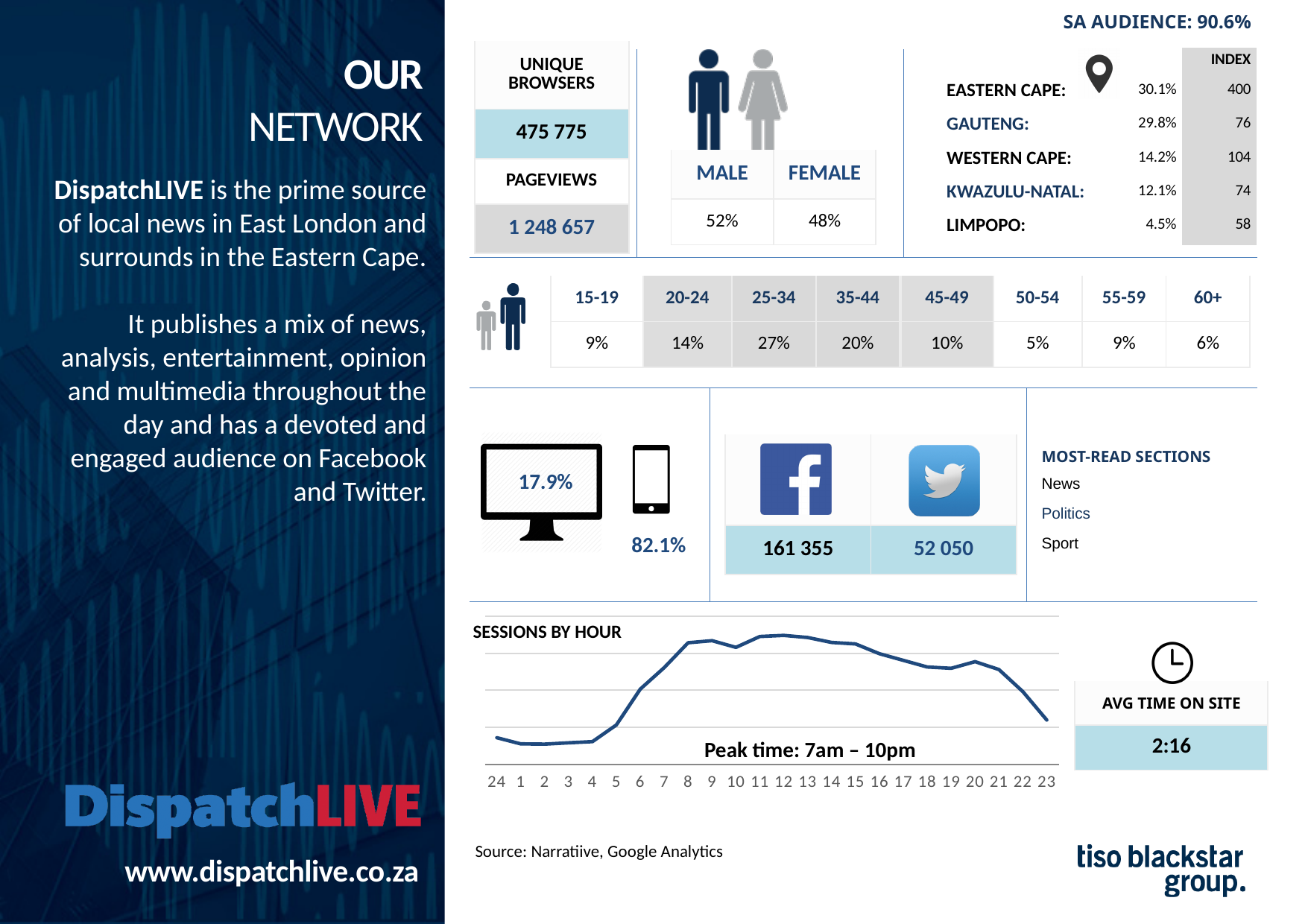
How many hour points are plotted along the x axis of the SESSIONS BY HOUR chart? 24 What kind of chart is the SESSIONS BY HOUR chart? line chart What is the first label on the x axis of the SESSIONS BY HOUR chart? 24 In the SESSIONS BY HOUR chart, which hour has more sessions, hour 23 or hour 20? 20 How many lines are plotted in the SESSIONS BY HOUR chart? 1 According to the annotation on the SESSIONS BY HOUR chart, what is the peak time? 7am – 10pm In the SESSIONS BY HOUR chart, do sessions rise or fall between hour 20 and hour 23? fall What is the title of the chart at the bottom of the slide? SESSIONS BY HOUR In the SESSIONS BY HOUR chart, which hour has more sessions, hour 4 or hour 9? 9 In the SESSIONS BY HOUR chart, do sessions rise or fall between hour 4 and hour 8? rise In the SESSIONS BY HOUR chart, which hour has more sessions, hour 12 or hour 2? 12